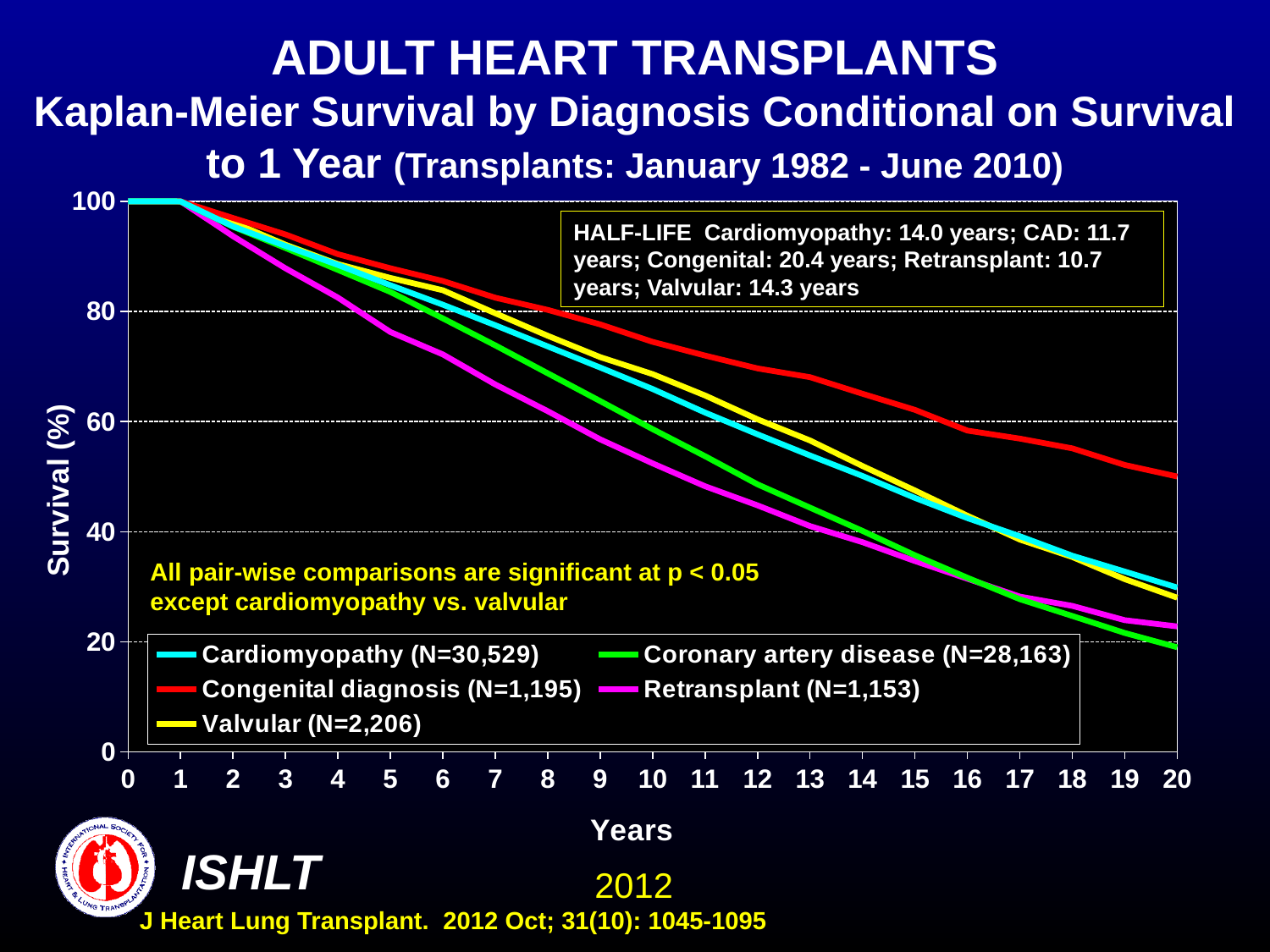
Do the survival curves rise or fall as years increase? fall What is the half-life for Congenital diagnosis given in the text box? 20.4 years Which series has the lowest survival at 10 years? Retransplant What is the difference between the Congenital half-life and the Retransplant half-life? 9.7 years How many series does the legend list? 5 What kind of chart is shown on the slide? line chart Is the survival for Congenital diagnosis at 20 years greater or less than 40? greater What is the half-life for Retransplant given in the text box? 10.7 years Which diagnosis has the longest half-life according to the text box? Congenital At 5 years, which is larger: survival for Congenital diagnosis or for Retransplant? Congenital diagnosis Is the survival for Retransplant at 10 years greater or less than 60? less Which series has the highest survival at 20 years? Congenital diagnosis